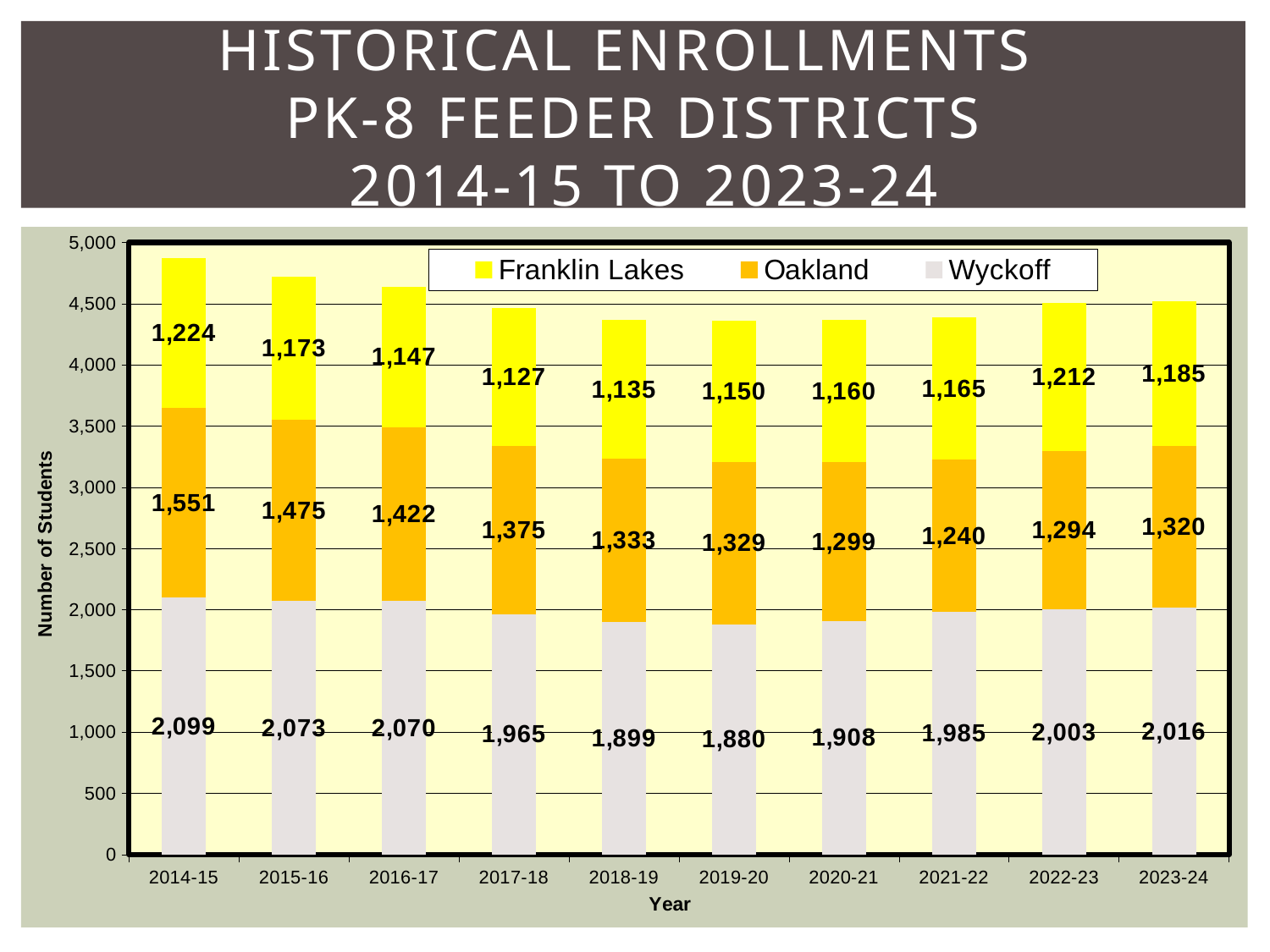
How many years are shown on the x axis? 10 What is the difference between the Oakland enrollment in 2014-15 and in 2023-24? 231 What was the Franklin Lakes enrollment in 2023-24? 1,185 What was the Oakland enrollment in 2021-22? 1,240 In which year was the Franklin Lakes enrollment lowest? 2017-18 In which year was the Wyckoff enrollment lowest? 2019-20 Which was larger in 2022-23, the Franklin Lakes enrollment or the Oakland enrollment? Oakland In which year was the Oakland enrollment highest? 2014-15 How many series does the legend list? 3 What was the Wyckoff enrollment in 2014-15? 2,099 What is the total enrollment across all three districts in 2014-15? 4,874 What is the total enrollment across all three districts in 2023-24? 4,521